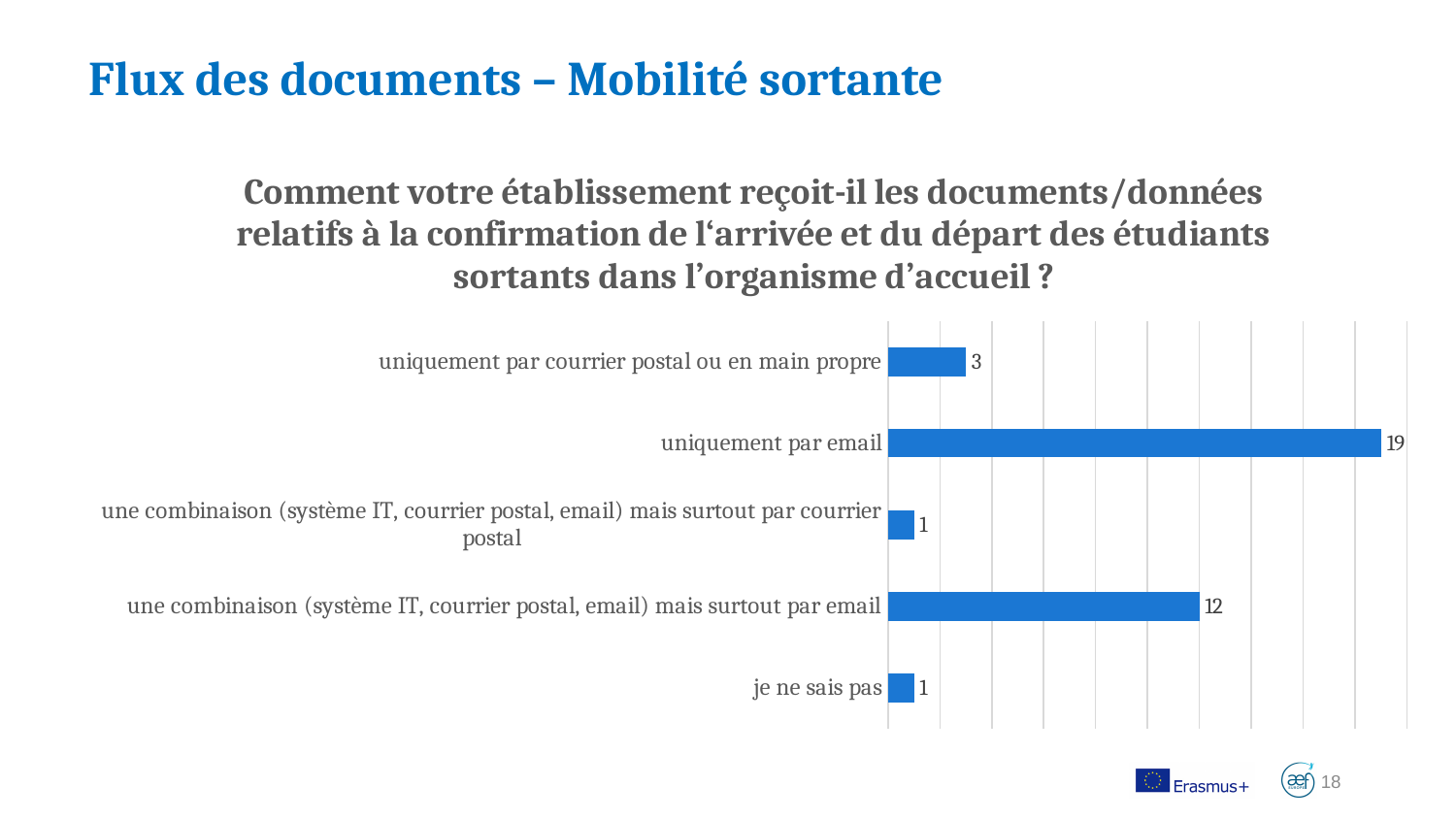
What colour are the bars in the chart? blue Which category has the highest value? uniquement par email What is the value for "je ne sais pas"? 1 What is the value for "uniquement par courrier postal ou en main propre"? 3 What is the difference between the values for "uniquement par email" and "une combinaison (système IT, courrier postal, email) mais surtout par email"? 7 What is the value for "une combinaison (système IT, courrier postal, email) mais surtout par email"? 12 What is the difference between the values for "uniquement par courrier postal ou en main propre" and "je ne sais pas"? 2 What is the value for "uniquement par email"? 19 Which is larger: the value for "uniquement par courrier postal ou en main propre" or the value for "une combinaison (système IT, courrier postal, email) mais surtout par courrier postal"? uniquement par courrier postal ou en main propre What is the total of all the values shown in the chart? 36 How many categories are shown in the chart? 5 What kind of chart is shown on the slide? bar chart